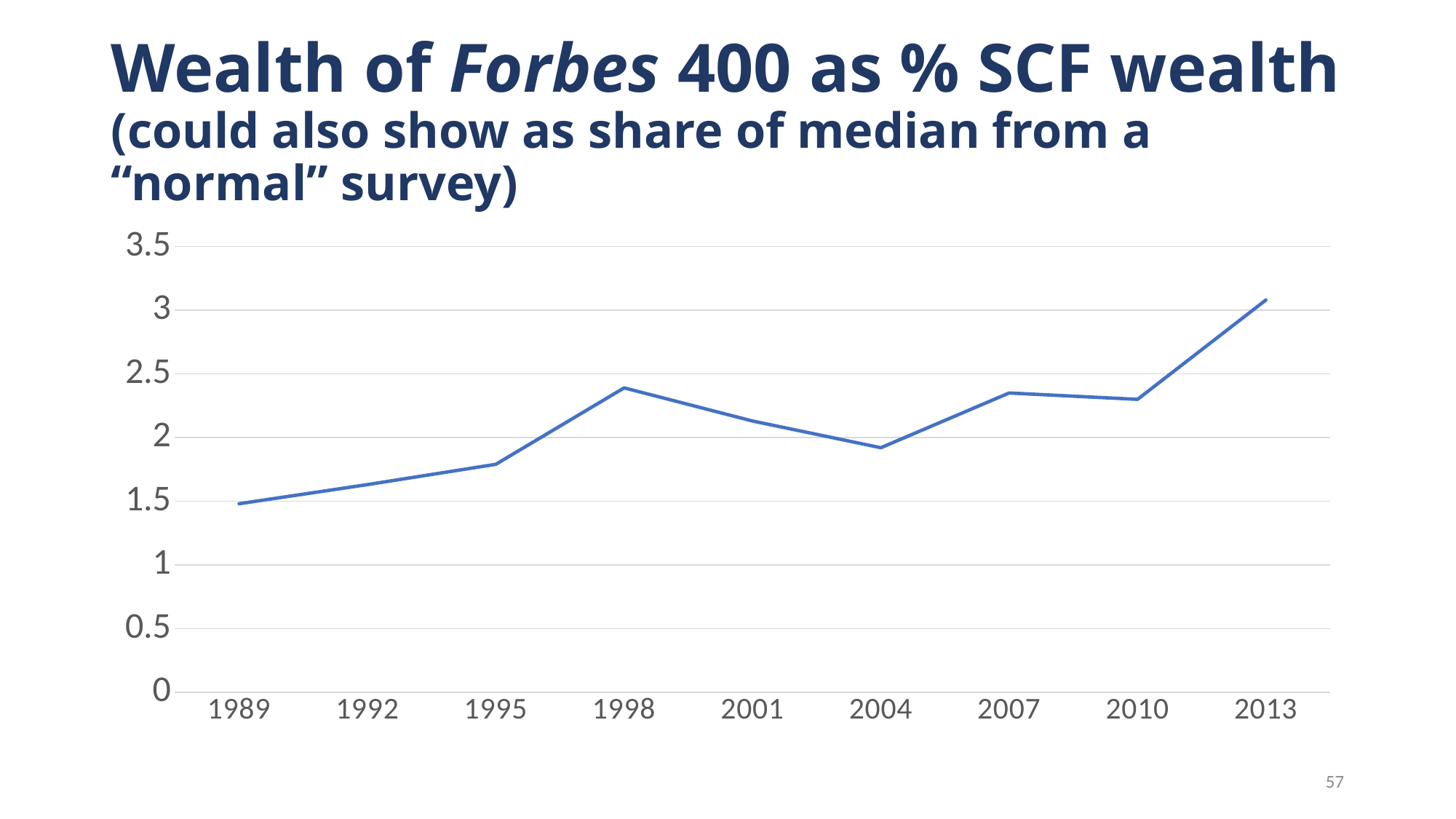
What is the title of the chart? Wealth of Forbes 400 as % SCF wealth How many years are plotted along the x axis? 9 Which year has the larger value, 1995 or 2001? 2001 Is the value for 2013 greater or less than 2.5? greater In which year is the value highest? 2013 Is the value for 1989 greater or less than 2? less Which year has the larger value, 1998 or 2004? 1998 Is the value for 1998 greater or less than 2? greater Do the values rise or fall from 1989 to 1998? rise In which year is the value lowest? 1989 What kind of chart is shown on the slide? line chart